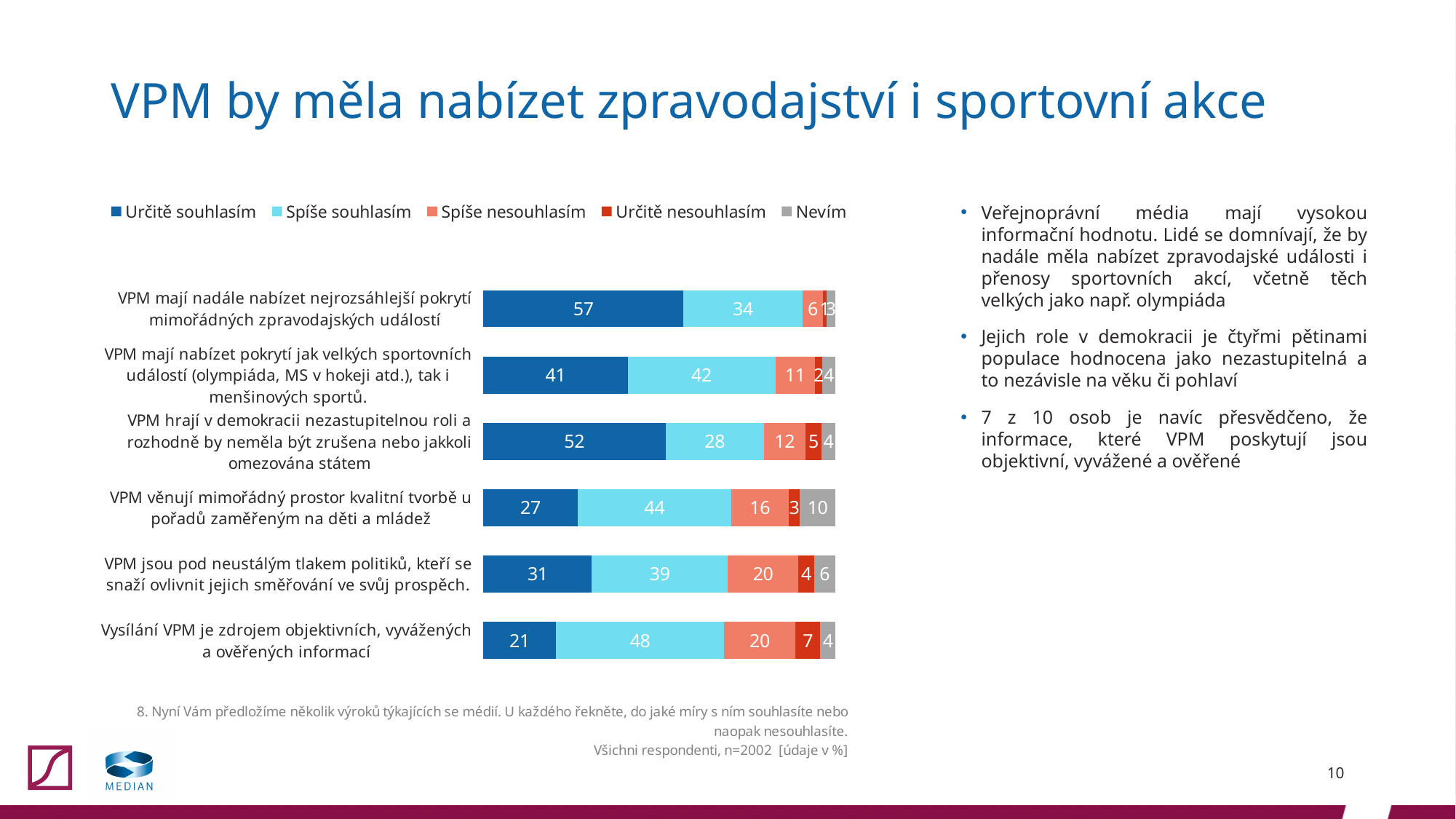
What is the "Určitě nesouhlasím" value for the statement "Vysílání VPM je zdrojem objektivních, vyvážených a ověřených informací"? 7 Which statement has the highest "Nevím" value? VPM věnují mimořádný prostor kvalitní tvorbě u pořadů zaměřeným na děti a mládež What kind of chart is shown on the slide? Stacked bar chart Which statement has the lowest "Určitě souhlasím" value? Vysílání VPM je zdrojem objektivních, vyvážených a ověřených informací What is the "Spíše souhlasím" value for the statement "VPM věnují mimořádný prostor kvalitní tvorbě u pořadů zaměřeným na děti a mládež"? 44 How many series does the legend list? 5 Which statement has the highest "Určitě souhlasím" value? VPM mají nadále nabízet nejrozsáhlejší pokrytí mimořádných zpravodajských událostí What is the "Nevím" value for the statement about programmes for children and youth ("VPM věnují mimořádný prostor kvalitní tvorbě u pořadů zaměřeným na děti a mládež")? 10 What percentage of respondents answered "Určitě souhlasím" to the statement "Vysílání VPM je zdrojem objektivních, vyvážených a ověřených informací"? 21 Which has a larger "Spíše nesouhlasím" value: the statement about VPM being under pressure from politicians, or the statement about VPM's irreplaceable role in democracy? The statement about pressure from politicians (20) How many statements (categories) are shown in the chart? 6 What is the difference between the "Určitě souhlasím" values for the statement about news coverage (57) and the statement about sports coverage (41)? 16